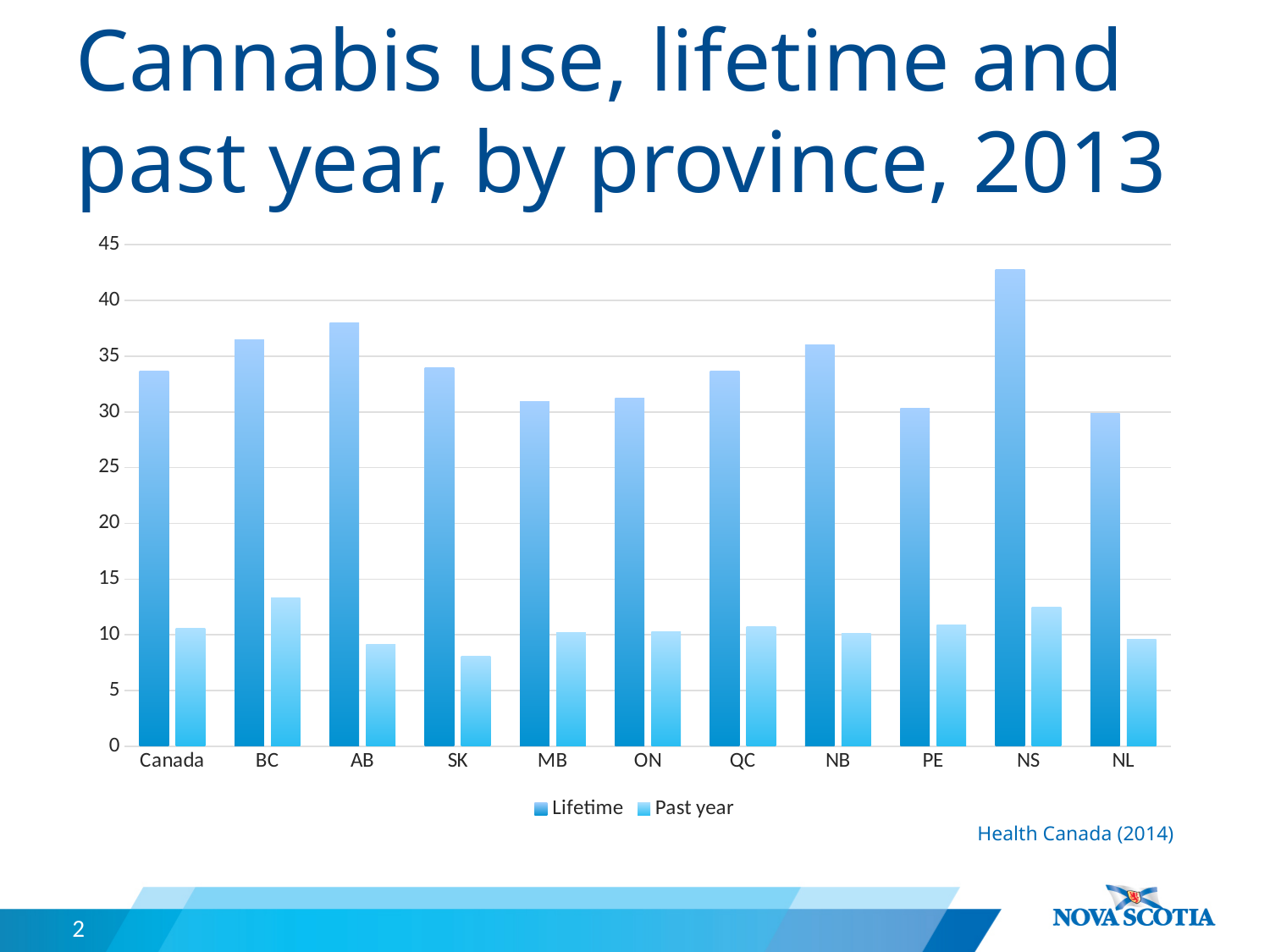
Is the Lifetime value for NS greater or less than 40? greater Is the Lifetime value for AB greater or less than 35? greater Which is larger, the Past year value for BC or the Past year value for AB? BC How many categories are shown on the x axis? 11 Is the Past year value for SK greater or less than 10? less Which category has the lowest Past year value? SK Which category has the highest Past year value? BC How many series does the legend list? 2 What is the title of the chart? Cannabis use, lifetime and past year, by province, 2013 Which category has the highest Lifetime value? NS Which is larger, the Lifetime value for AB or the Lifetime value for BC? AB What kind of chart is shown on the slide? bar chart